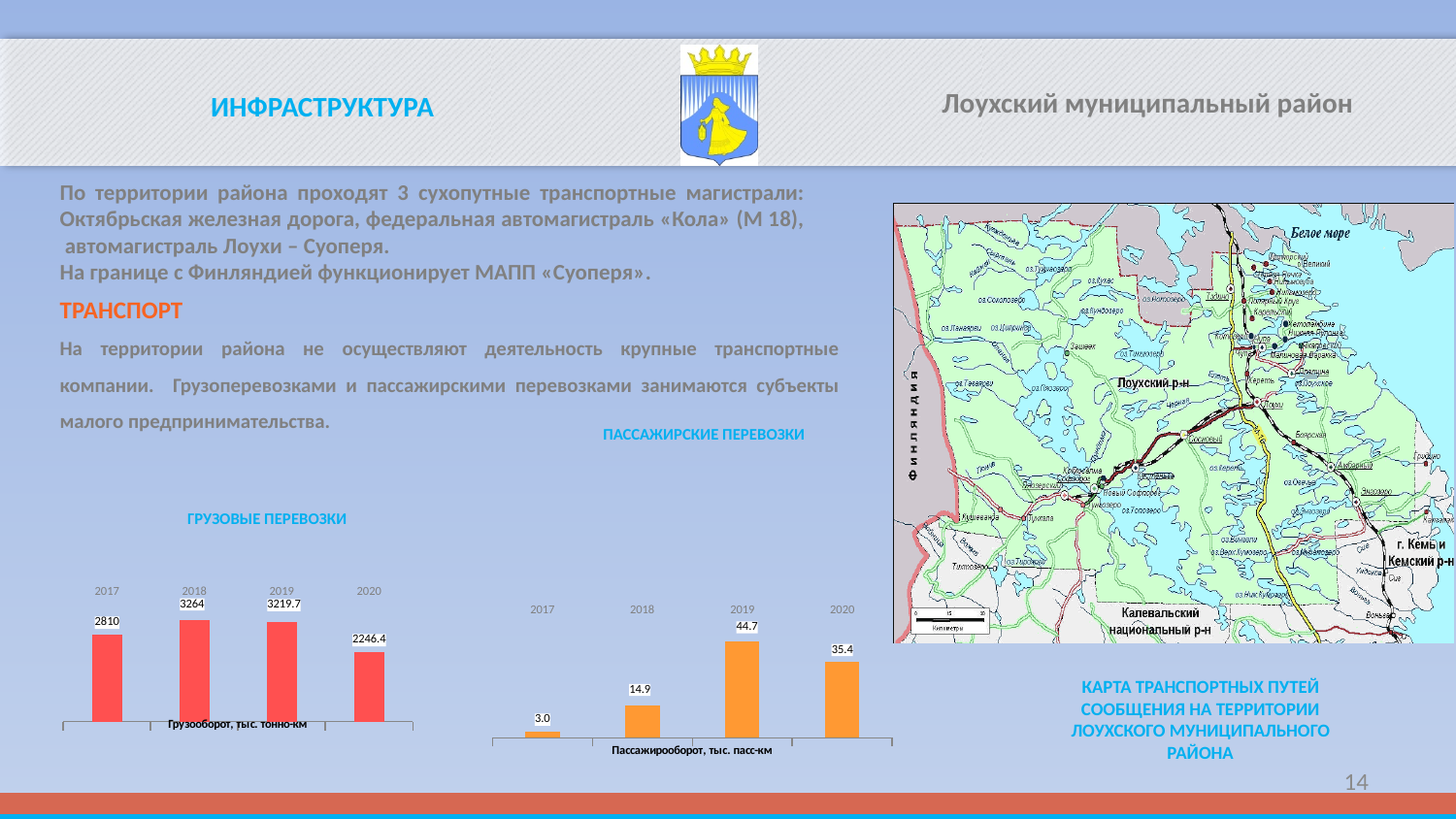
In the «ГРУЗОВЫЕ ПЕРЕВОЗКИ» chart, which year has the lowest value? 2020 In the «ПАССАЖИРСКИЕ ПЕРЕВОЗКИ» chart, what is the value for 2017? 3.0 In the «ГРУЗОВЫЕ ПЕРЕВОЗКИ» chart, what is the value for 2018? 3264 In the «ГРУЗОВЫЕ ПЕРЕВОЗКИ» chart, how many years are shown? 4 What is the series label shown under the «ПАССАЖИРСКИЕ ПЕРЕВОЗКИ» chart? Пассажирооборот, тыс. пасс-км What type of chart is the «ГРУЗОВЫЕ ПЕРЕВОЗКИ» chart? Bar chart In the «ПАССАЖИРСКИЕ ПЕРЕВОЗКИ» chart, what is the difference between the 2019 and 2020 values? 9.3 In the «ГРУЗОВЫЕ ПЕРЕВОЗКИ» chart, what is the difference between the 2017 and 2020 values? 563.6 In the «ГРУЗОВЫЕ ПЕРЕВОЗКИ» chart, what is the value for 2020? 2246.4 In the «ПАССАЖИРСКИЕ ПЕРЕВОЗКИ» chart, which is larger, the value for 2018 or the value for 2020? 2020 In the «ПАССАЖИРСКИЕ ПЕРЕВОЗКИ» chart, what is the value for 2019? 44.7 In the «ПАССАЖИРСКИЕ ПЕРЕВОЗКИ» chart, which year has the highest value? 2019